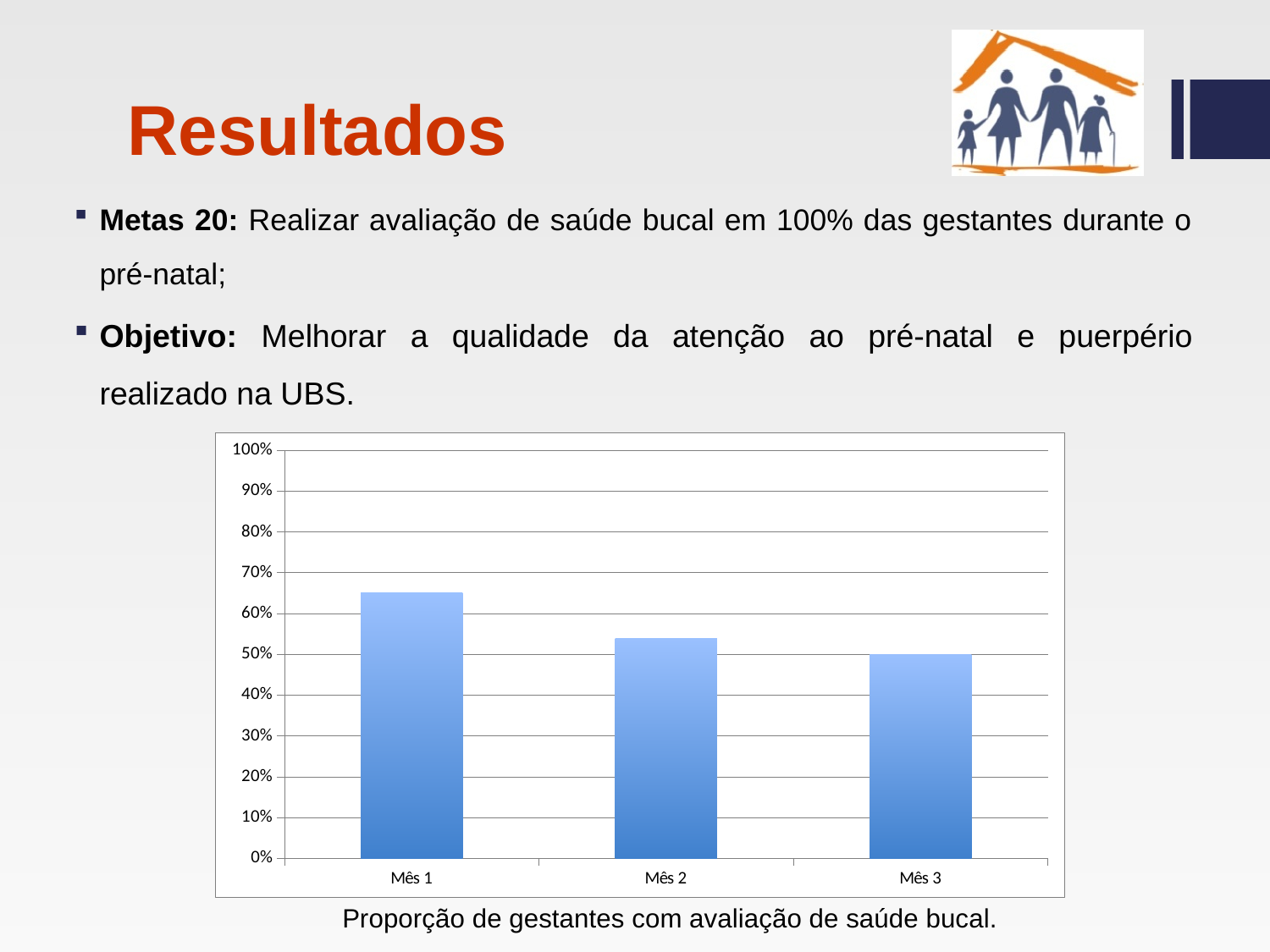
How many categories (months) are plotted on the chart? 3 Which is larger, the value for Mês 1 or the value for Mês 2? Mês 1 What is the value for Mês 3? 50% Which month has the highest proportion of pregnant women with oral health evaluation? Mês 1 What kind of chart is shown on the slide? Bar chart Is the value for Mês 2 greater or less than 60%? less Is the value for Mês 3 greater or less than 60%? less Which month has the lowest proportion of pregnant women with oral health evaluation? Mês 3 Is the value for Mês 2 greater or less than 50%? greater Do the values rise or fall from Mês 1 to Mês 3? fall What is the caption written below the chart? Proporção de gestantes com avaliação de saúde bucal.